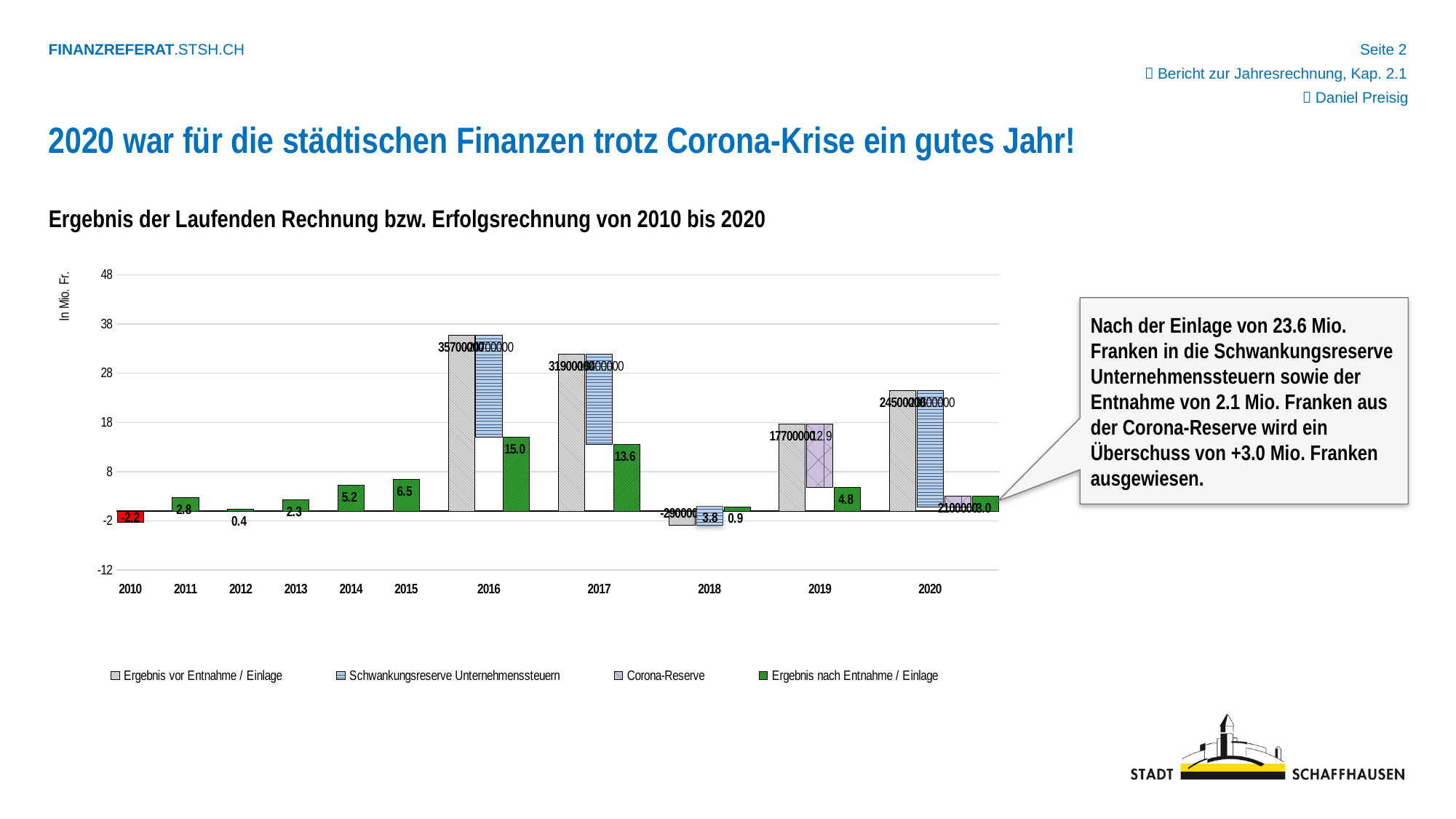
What is the value of Ergebnis nach Entnahme / Einlage for 2020? 3.0 What is the value of Ergebnis nach Entnahme / Einlage for 2010? -2.2 What is the value of Corona-Reserve for 2019? 12.9 What is the difference between the Ergebnis nach Entnahme / Einlage for 2016 and 2017? 1.4 Does the Ergebnis nach Entnahme / Einlage rise or fall from 2012 to 2016? Rise Which year has the highest Ergebnis nach Entnahme / Einlage? 2016 What kind of chart is shown on the slide? Bar chart Which is larger, the Ergebnis nach Entnahme / Einlage for 2014 or for 2015? 2015 How many series does the legend list? 4 How many years are shown on the x axis? 11 What is the value of Ergebnis nach Entnahme / Einlage for 2016? 15.0 Which year has the lowest Ergebnis nach Entnahme / Einlage? 2010